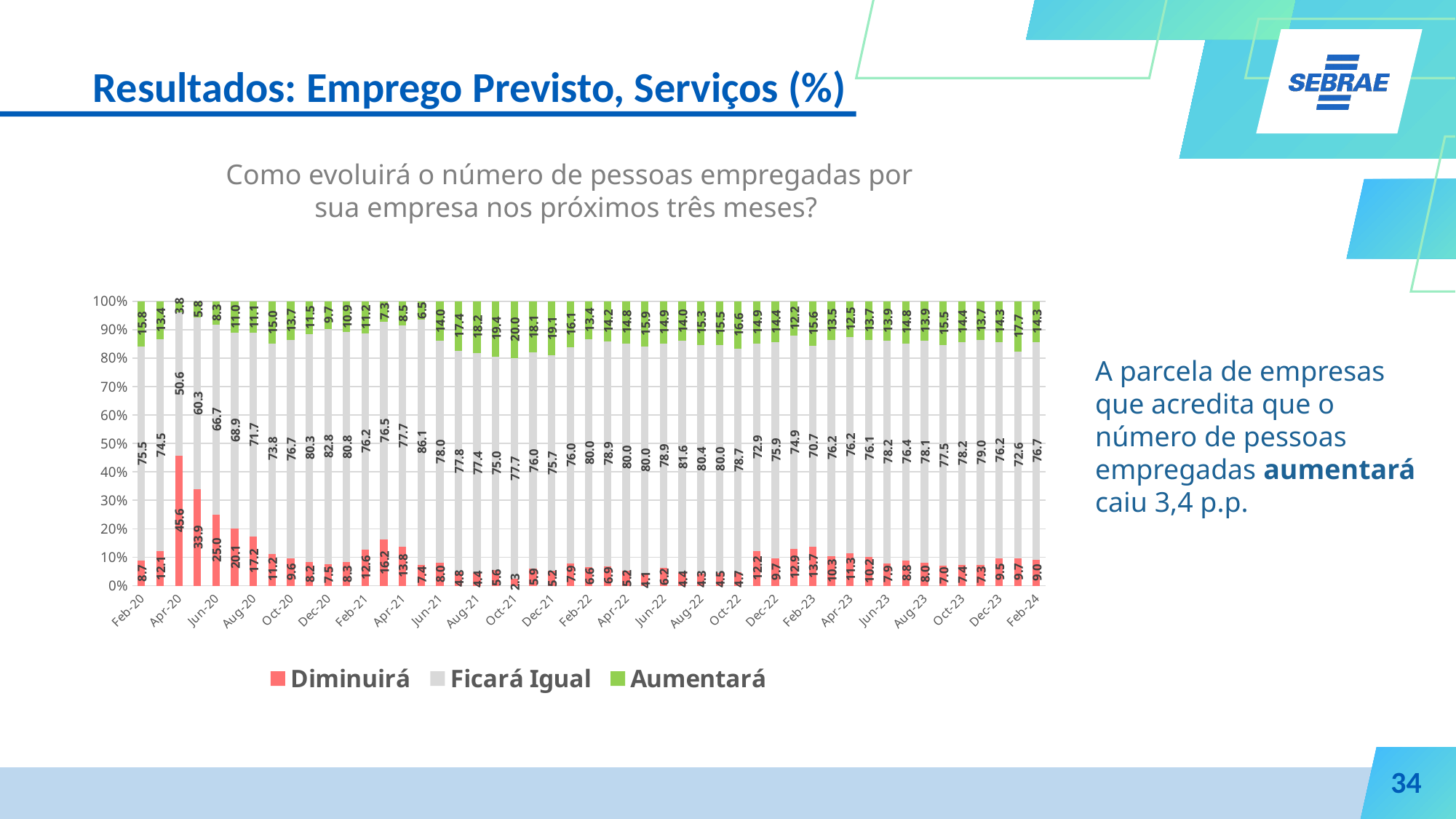
How many series does the chart legend list? 3 What is the difference between the Aumentará value for Feb-20 and for Feb-24? 1.5 In which month is the Diminuirá value highest? Apr-20 What kind of chart is shown on the slide? Stacked bar chart What is the value of Aumentará for Oct-21? 20.0 What is the value of Diminuirá for Apr-20? 45.6 What are the three series listed in the chart legend? Diminuirá, Ficará Igual, Aumentará What is the value of Ficará Igual for Feb-24? 76.7 What is the total of the stacked bar for Feb-24? 100.0 In which month is the Aumentará value lowest? Apr-20 What is the value of Aumentará for Feb-20? 15.8 Which is larger, the Diminuirá value for Feb-23 or for Feb-24? Feb-23